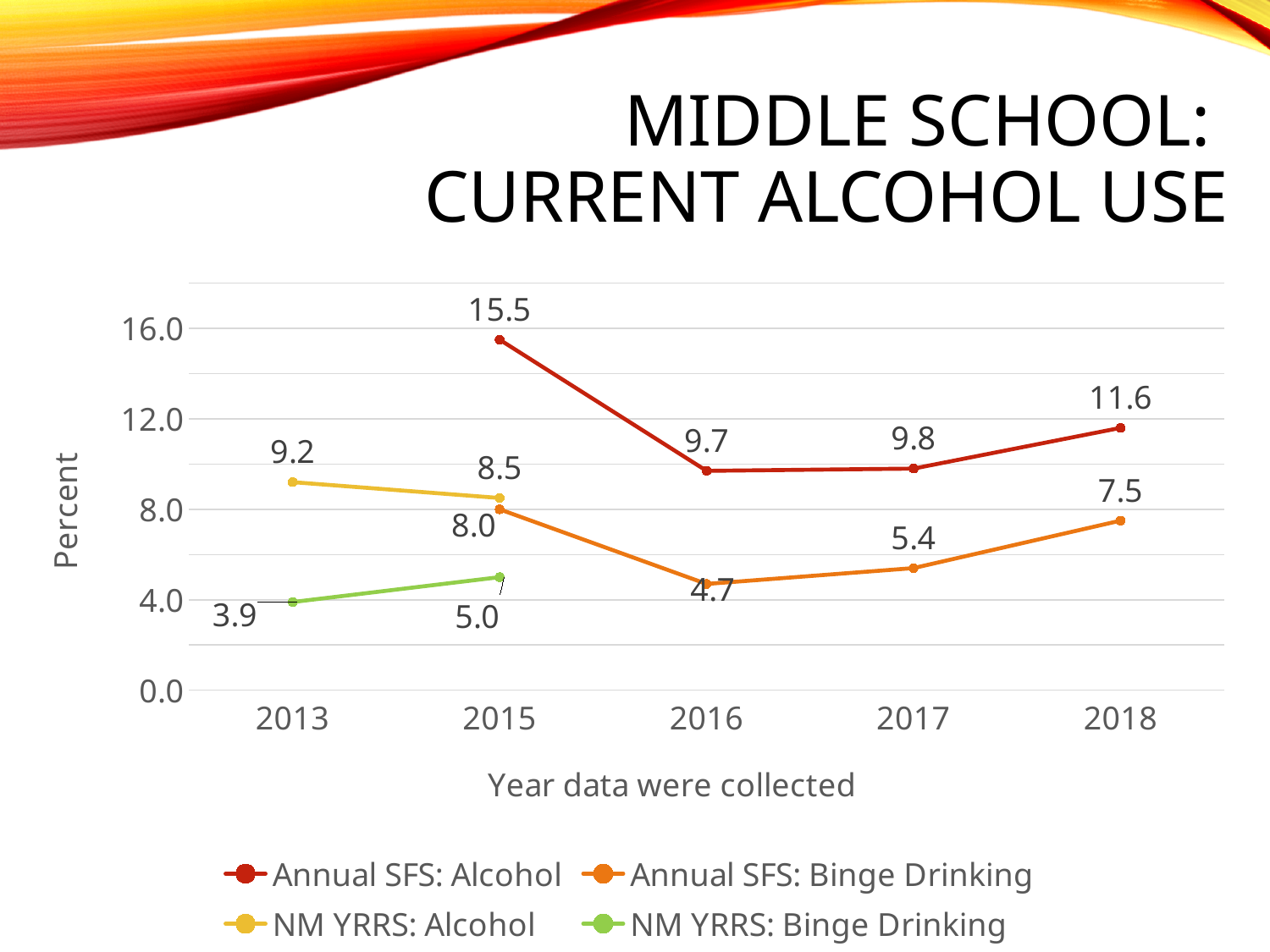
In which year is the Annual SFS: Alcohol series highest? 2015 What is the value for Annual SFS: Alcohol in 2015? 15.5 What is the difference between Annual SFS: Alcohol in 2015 and in 2016? 5.8 How many series does the legend list? 4 Which is larger in 2015: NM YRRS: Alcohol or Annual SFS: Binge Drinking? NM YRRS: Alcohol What kind of chart is shown on the slide? Line chart Does the NM YRRS: Binge Drinking series rise or fall from 2013 to 2015? Rise In which year is the Annual SFS: Binge Drinking series lowest? 2016 What is the value for NM YRRS: Alcohol in 2013? 9.2 Is the value for Annual SFS: Alcohol in 2018 greater or less than 12.0? less What is the value for Annual SFS: Binge Drinking in 2018? 7.5 What is the value for NM YRRS: Binge Drinking in 2015? 5.0